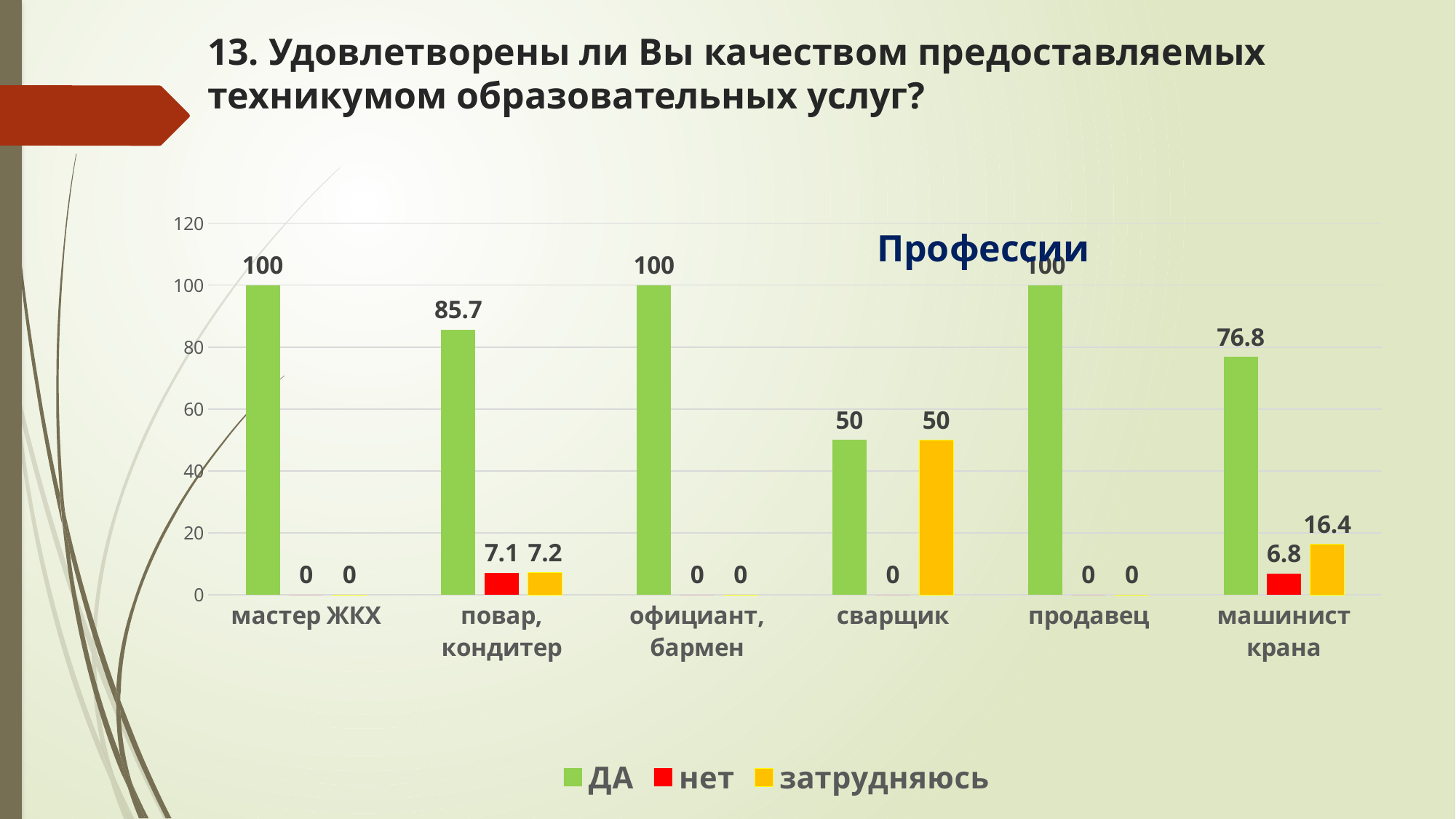
Which category has the highest value in the затрудняюсь series? сварщик What is the value of the затрудняюсь series for машинист крана? 16.4 What is the value of the затрудняюсь series for сварщик? 50 What is the title of the chart? Профессии How many categories are shown on the x axis? 6 How many series does the legend list? 3 Which is larger for машинист крана: the нет value or the затрудняюсь value? затрудняюсь Which category has the lowest value in the ДА series? сварщик What is the value of the ДА series for повар, кондитер? 85.7 What is the value of the нет series for машинист крана? 6.8 What is the difference between the ДА values for повар, кондитер and машинист крана? 8.9 What kind of chart is shown on the slide? bar chart